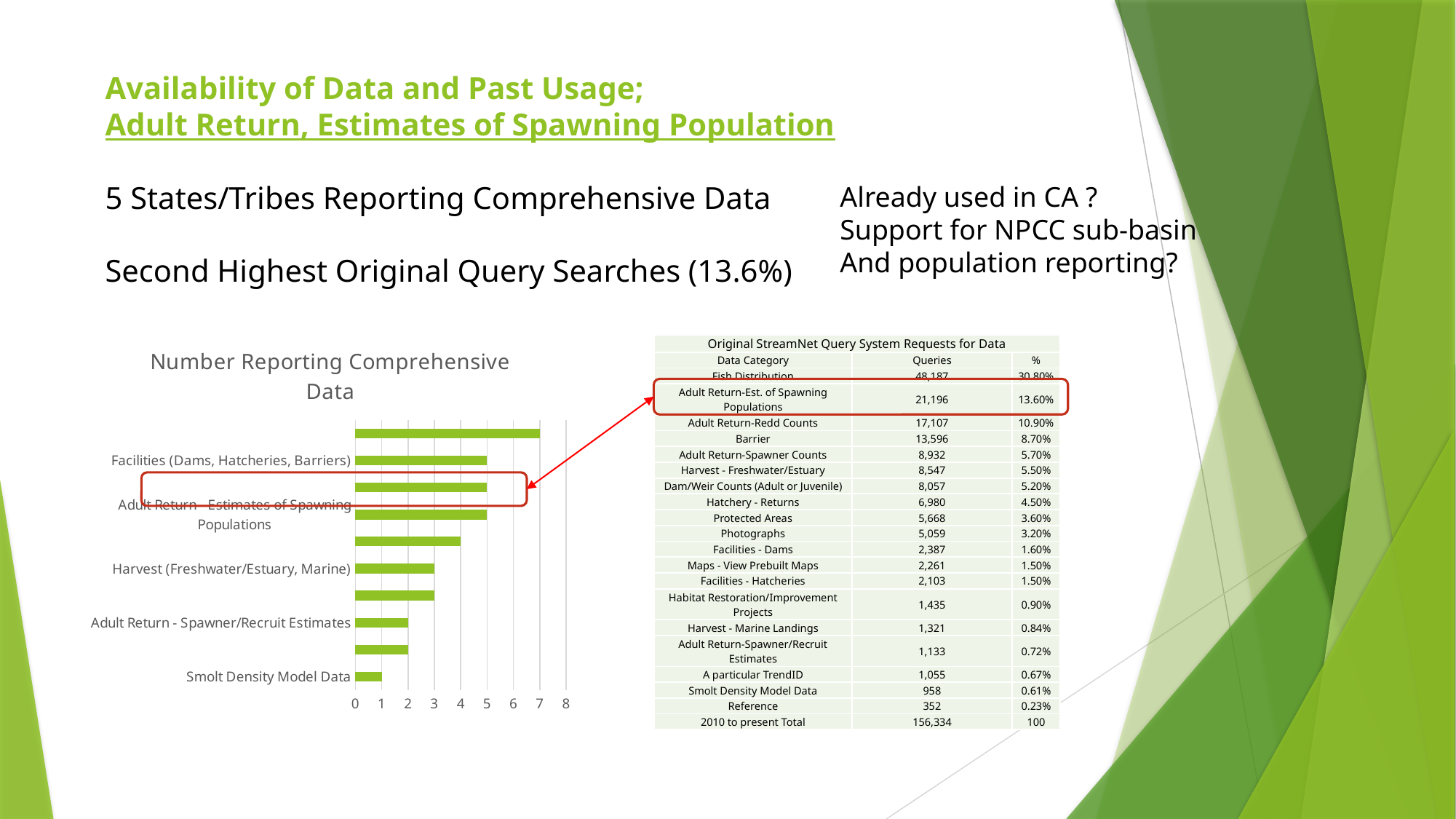
In the 'Number Reporting Comprehensive Data' chart, which category has the lowest value? Smolt Density Model Data In the 'Number Reporting Comprehensive Data' chart, what is the value for Smolt Density Model Data? 1 In the 'Number Reporting Comprehensive Data' chart, what is the difference between Facilities (Dams, Hatcheries, Barriers) and Harvest (Freshwater/Estuary, Marine)? 2 How many bars are plotted in the 'Number Reporting Comprehensive Data' chart? 10 In the 'Number Reporting Comprehensive Data' chart, what is the value for Facilities (Dams, Hatcheries, Barriers)? 5 In the 'Number Reporting Comprehensive Data' chart, is the value for Smolt Density Model Data greater or less than 2? less In the 'Number Reporting Comprehensive Data' chart, what is the value for Adult Return - Estimates of Spawning Populations? 5 What kind of chart is 'Number Reporting Comprehensive Data'? bar chart In the 'Number Reporting Comprehensive Data' chart, which is larger: Facilities (Dams, Hatcheries, Barriers) or Harvest (Freshwater/Estuary, Marine)? Facilities (Dams, Hatcheries, Barriers) In the 'Number Reporting Comprehensive Data' chart, what is the value for Harvest (Freshwater/Estuary, Marine)? 3 What is the highest value shown on the x axis of the 'Number Reporting Comprehensive Data' chart? 8 In the 'Number Reporting Comprehensive Data' chart, what is the value for Adult Return - Spawner/Recruit Estimates? 2